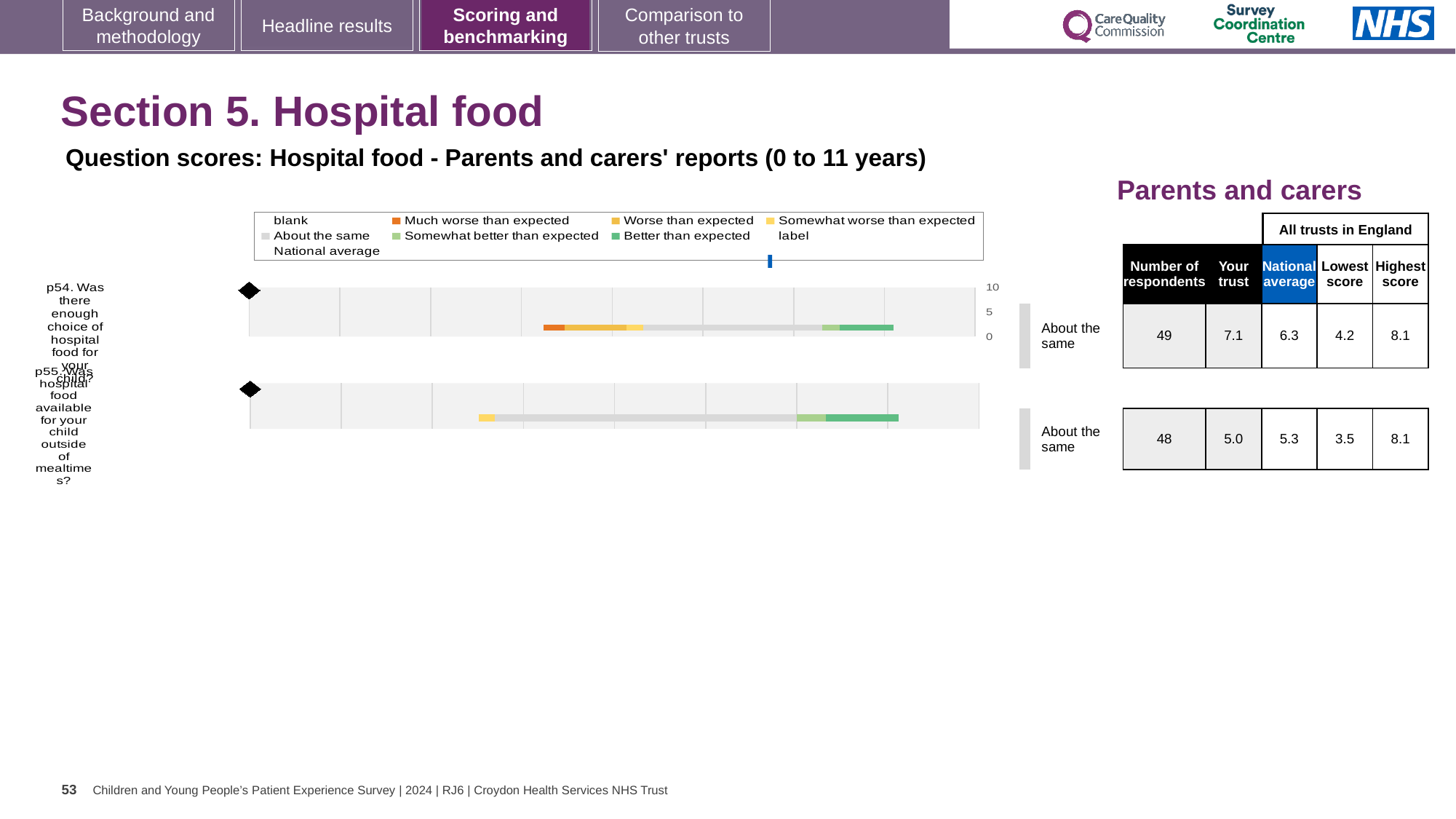
How many respondents answered p54? 49 What is the difference between the 'Your trust' score and the national average for p54? 0.8 What benchmark category is shown for p54? About the same What kind of chart is used to show the question scores? Bar chart What is the national average score for p55 (Was hospital food available for your child outside of mealtimes?)? 5.3 What is the lowest score among all trusts in England for p54? 4.2 Which question has the higher 'Your trust' score, p54 or p55? p54 What is the highest score among all trusts in England for p55? 8.1 How many questions are plotted on the chart? 2 What is the 'Your trust' score for p55? 5.0 What is the difference between the highest and lowest scores for p55? 4.6 What is the 'Your trust' score for p54 (Was there enough choice of hospital food for your child?)? 7.1